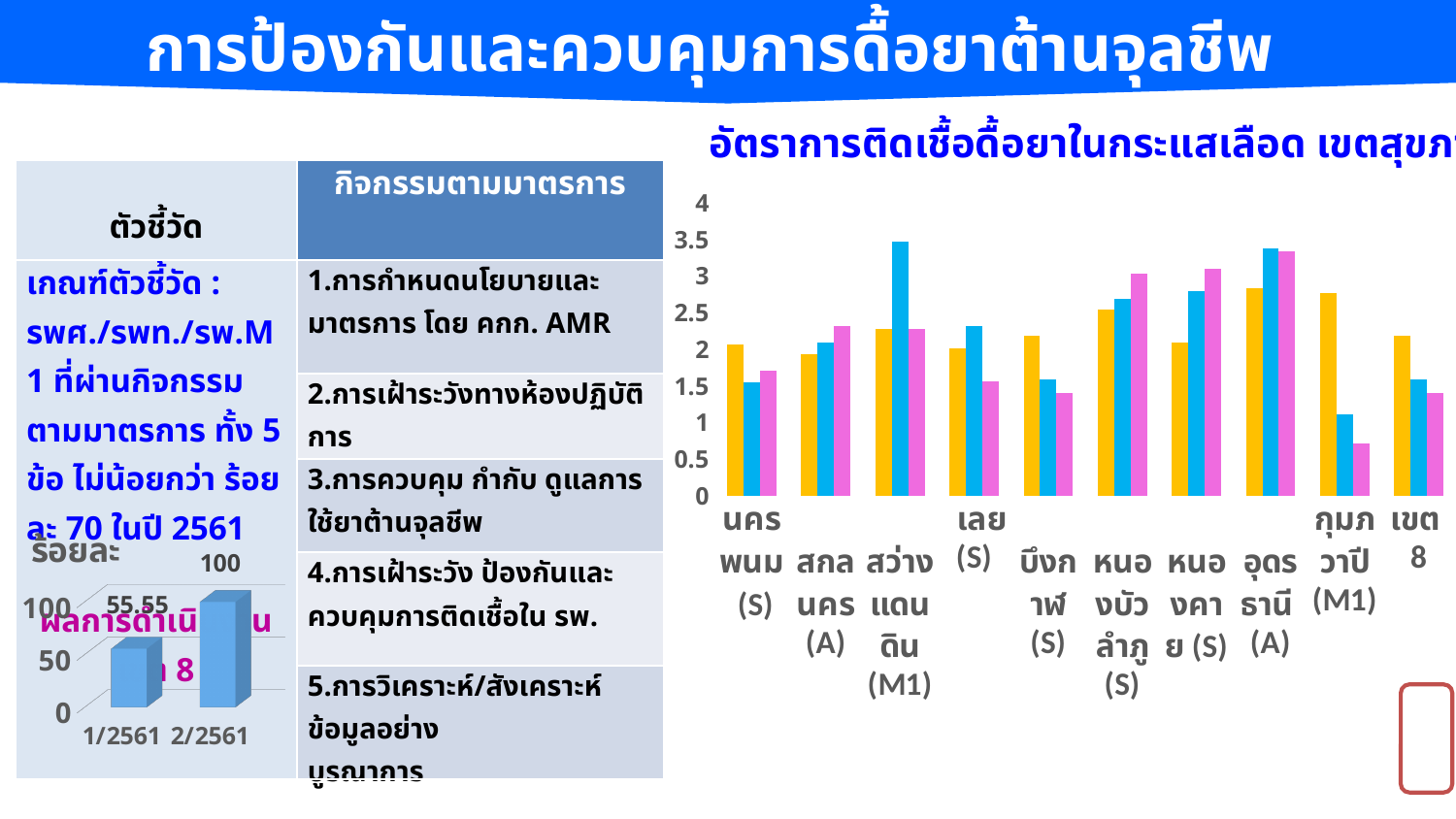
What kind of chart is the small chart on the left (ร้อยละ)? bar chart What kind of chart is the large chart on the right (อัตราการติดเชื้อดื้อยาในกระแสเลือด)? bar chart In the small chart on the left (ร้อยละ), what is the value for 2/2561? 100 In the large chart on the right (อัตราการติดเชื้อดื้อยาในกระแสเลือด), how many categories are shown on the x axis? 10 In the large chart on the right, is the blue bar for สว่างแดนดิน (M1) greater or less than 3? greater In the small chart on the left (ร้อยละ), what is the difference between the values for 2/2561 and 1/2561? 44.45 In the small chart on the left (ร้อยละ), what is the value for 1/2561? 55.55 In the large chart on the right, is the pink bar for กุมภวาปี (M1) greater or less than 1? less In the small chart on the left (ร้อยละ), do the values rise or fall from 1/2561 to 2/2561? rise In the large chart on the right, how many bars are shown for each category? 3 In the small chart on the left (ร้อยละ), how many categories are shown on the x axis? 2 In the large chart on the right, for เขต 8, which is larger: the yellow bar or the pink bar? the yellow bar